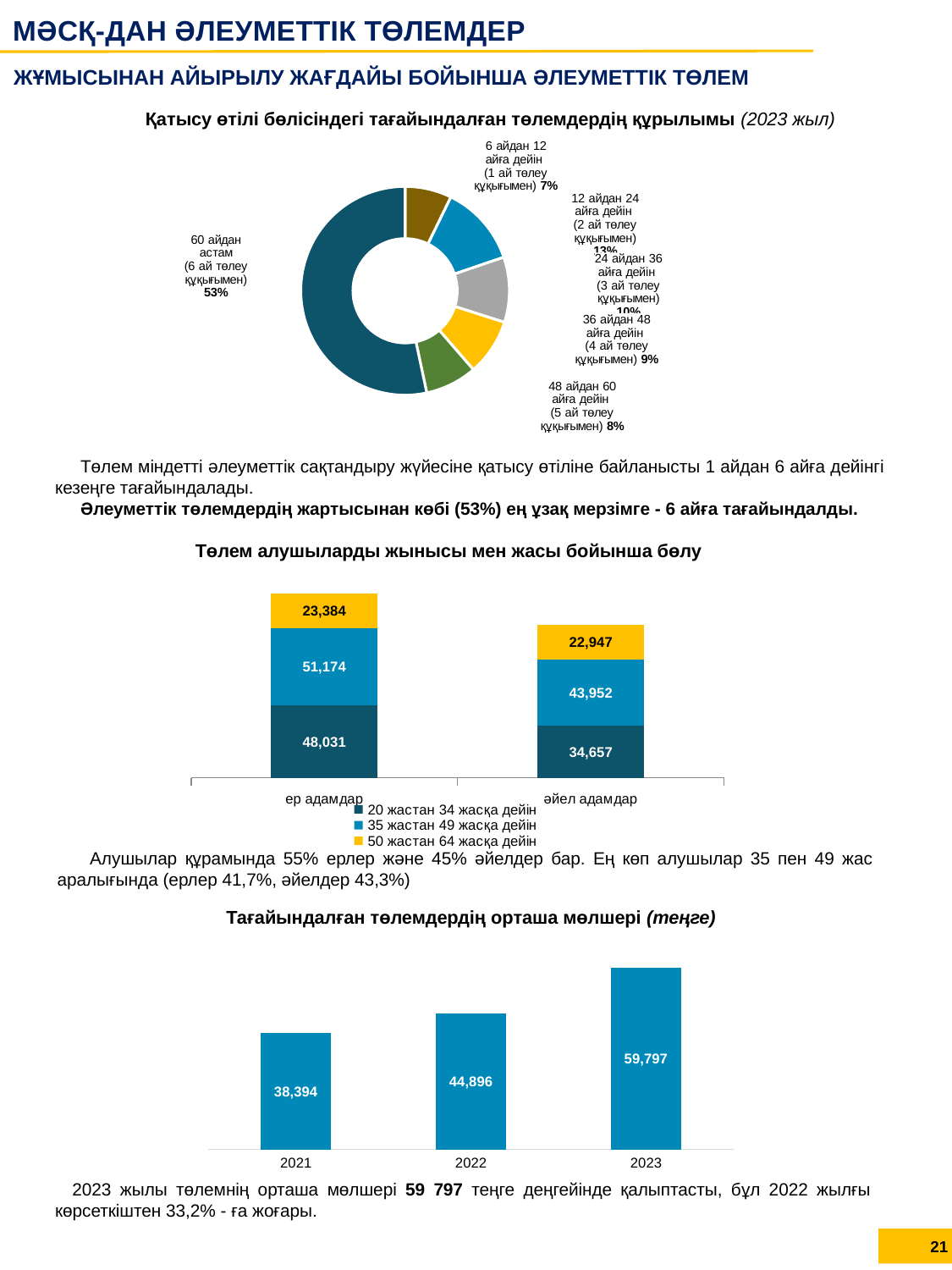
In the chart 'Төлем алушыларды жынысы мен жасы бойынша бөлу', what is the difference between the '50 жастан 64 жасқа дейін' values for 'ер адамдар' and 'әйел адамдар'? 437 In the donut chart at the top of the slide, which category has the largest share? 60 айдан астам (6 ай төлеу құқығымен) In the chart 'Тағайындалған төлемдердің орташа мөлшері (теңге)', what is the difference between the 2023 and 2021 values? 21,403 In the chart 'Тағайындалған төлемдердің орташа мөлшері (теңге)', do the values rise or fall from 2021 to 2023? rise In the chart 'Төлем алушыларды жынысы мен жасы бойынша бөлу', what is the value for '35 жастан 49 жасқа дейін' for 'ер адамдар'? 51,174 In the donut chart at the top of the slide, which is larger: the share for '36 айдан 48 айға дейін' or the share for '48 айдан 60 айға дейін'? 36 айдан 48 айға дейін In the chart 'Төлем алушыларды жынысы мен жасы бойынша бөлу', how many series does the legend list? 3 In the chart 'Төлем алушыларды жынысы мен жасы бойынша бөлу', what is the total of the stacked bar for 'ер адамдар'? 122,589 In the donut chart at the top of the slide, what share is shown for '6 айдан 12 айға дейін (1 ай төлеу құқығымен)'? 7% In the donut chart 'Қатысу өтілі бөлісіндегі тағайындалған төлемдердің құрылымы (2023 жыл)', what share is shown for '60 айдан астам (6 ай төлеу құқығымен)'? 53% In the chart 'Төлем алушыларды жынысы мен жасы бойынша бөлу', what is the value for '20 жастан 34 жасқа дейін' for 'әйел адамдар'? 34,657 In the chart 'Тағайындалған төлемдердің орташа мөлшері (теңге)', what is the value for 2022? 44,896